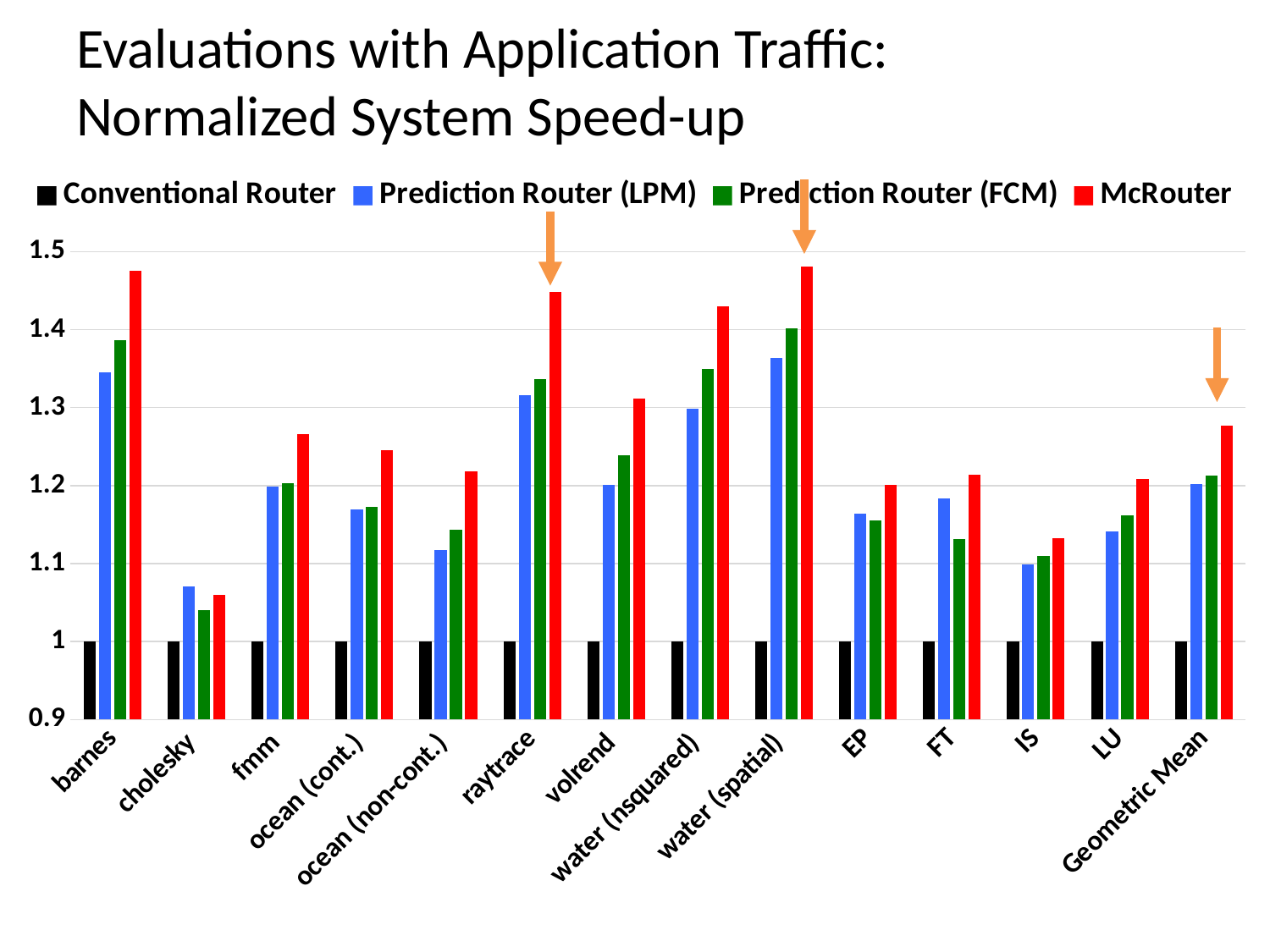
What colour represents McRouter in the legend? red How many categories are shown along the x axis? 14 How many series does the legend list? 4 Is the McRouter value for cholesky greater or less than 1.1? less For FT, which is larger: the Prediction Router (FCM) value or the McRouter value? McRouter Is the McRouter value for barnes greater or less than 1.4? greater Which category has the lowest McRouter value? cholesky What is the Conventional Router value for Geometric Mean? 1 Which category has the lowest Prediction Router (FCM) value? cholesky What is the Conventional Router value for barnes? 1 What kind of chart is shown on the slide? bar chart Which series has the highest value for raytrace? McRouter